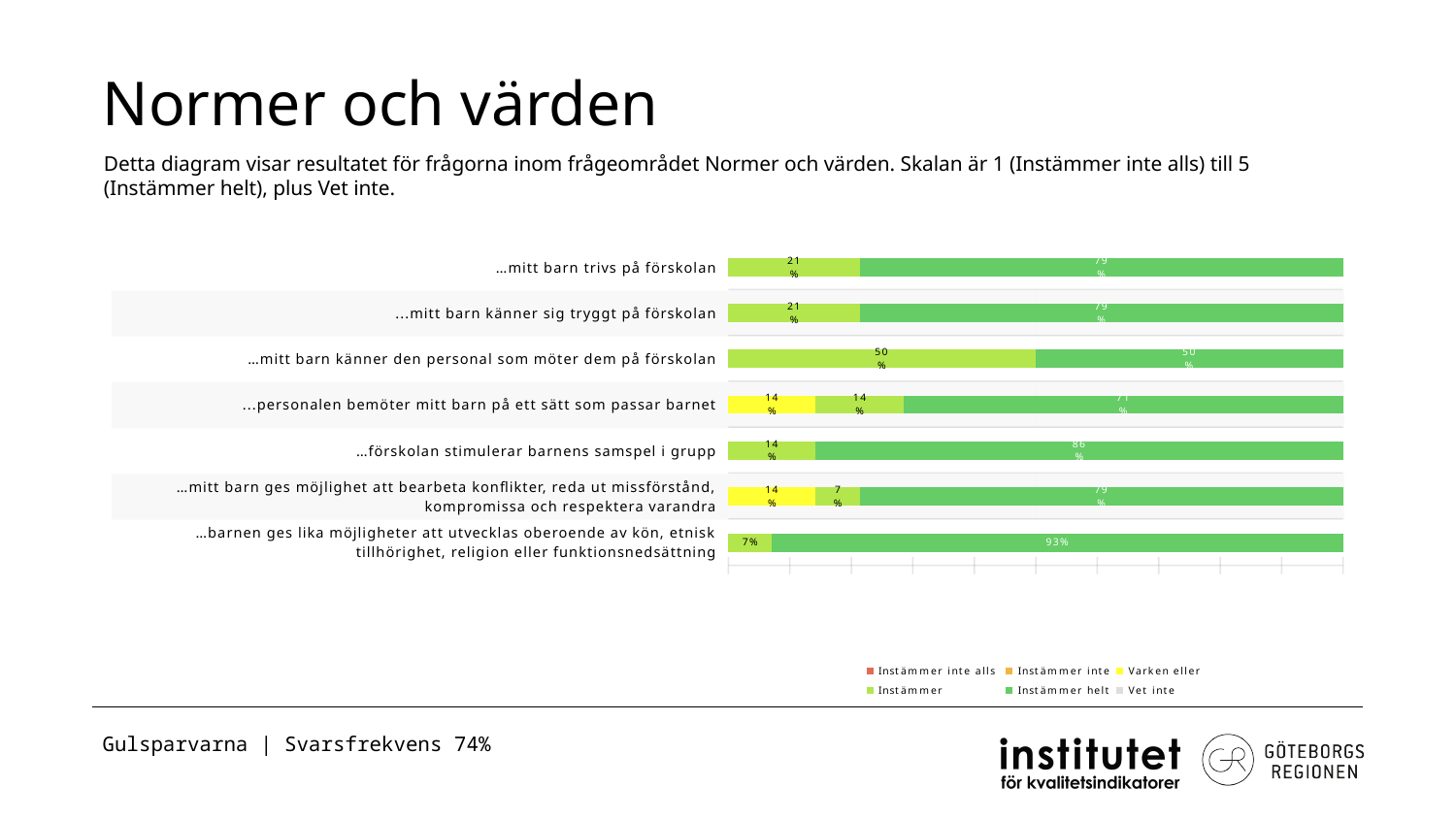
What is the difference between the 'Instämmer helt' values for '…förskolan stimulerar barnens samspel i grupp' and '…personalen bemöter mitt barn på ett sätt som passar barnet'? 15% What is the 'Instämmer helt' value for '…mitt barn trivs på förskolan'? 79% What is the 'Instämmer helt' value for '…barnen ges lika möjligheter att utvecklas oberoende av kön, etnisk tillhörighet, religion eller funktionsnedsättning'? 93% What kind of chart is shown on the slide? Stacked bar chart Which category has the lowest 'Instämmer helt' value? …mitt barn känner den personal som möter dem på förskolan What is the total of the 'Instämmer' and 'Instämmer helt' values for '…mitt barn känner sig tryggt på förskolan'? 100% What is the 'Instämmer' value for '…mitt barn känner den personal som möter dem på förskolan'? 50% What is the 'Varken eller' value for '…mitt barn ges möjlighet att bearbeta konflikter, reda ut missförstånd, kompromissa och respektera varandra'? 14% How many series does the legend list? 6 Which category has the highest 'Instämmer helt' value? …barnen ges lika möjligheter att utvecklas oberoende av kön, etnisk tillhörighet, religion eller funktionsnedsättning Which is larger: the 'Instämmer' value for '…mitt barn trivs på förskolan' or the 'Instämmer' value for '…förskolan stimulerar barnens samspel i grupp'? …mitt barn trivs på förskolan How many categories (questions) are plotted in the chart? 7